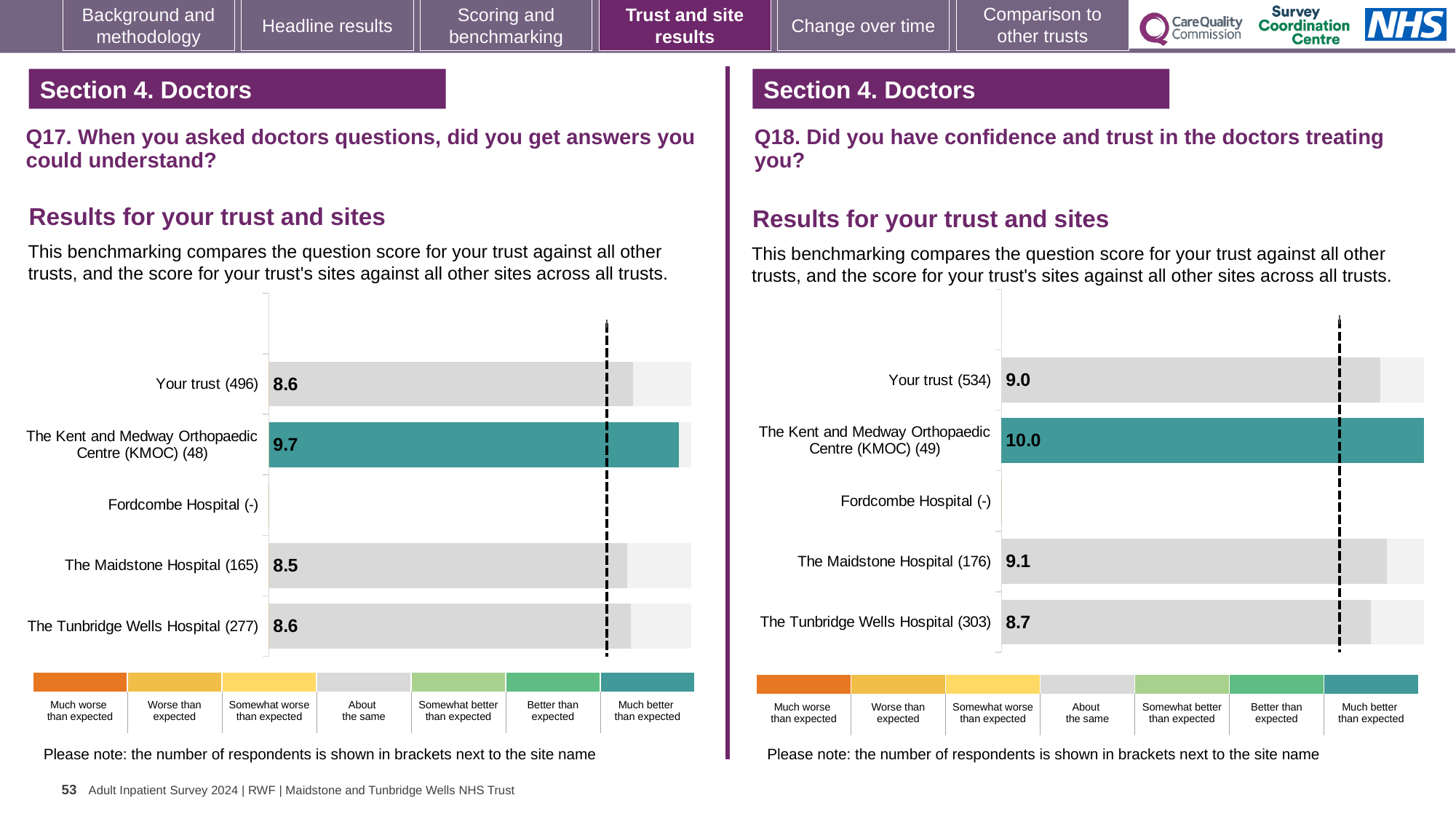
On the Q17 chart, what is the score for The Kent and Medway Orthopaedic Centre (KMOC) (48)? 9.7 On the Q17 chart, which site's bar is coloured teal rather than grey? The Kent and Medway Orthopaedic Centre (KMOC) (48) How many sites or rows are listed on the vertical axis of the Q17 chart? 5 On the Q18 chart, what is the score for The Maidstone Hospital (176)? 9.1 On the Q17 chart, which site has the lowest score? The Maidstone Hospital (165) On the Q17 chart, what is the score for Your trust (496)? 8.6 On the Q18 chart, what is the difference between the scores for The Kent and Medway Orthopaedic Centre (KMOC) and Your trust? 1.0 On the Q18 chart, which site has the highest score? The Kent and Medway Orthopaedic Centre (KMOC) (49) On the Q17 chart, what is the difference between the scores for The Kent and Medway Orthopaedic Centre (KMOC) and The Maidstone Hospital? 1.2 What kind of chart is used on the Q18 side of the slide? Bar chart On the Q18 chart, what is the score for The Tunbridge Wells Hospital (303)? 8.7 On the Q18 chart, which is larger: the score for Your trust or the score for The Tunbridge Wells Hospital? Your trust